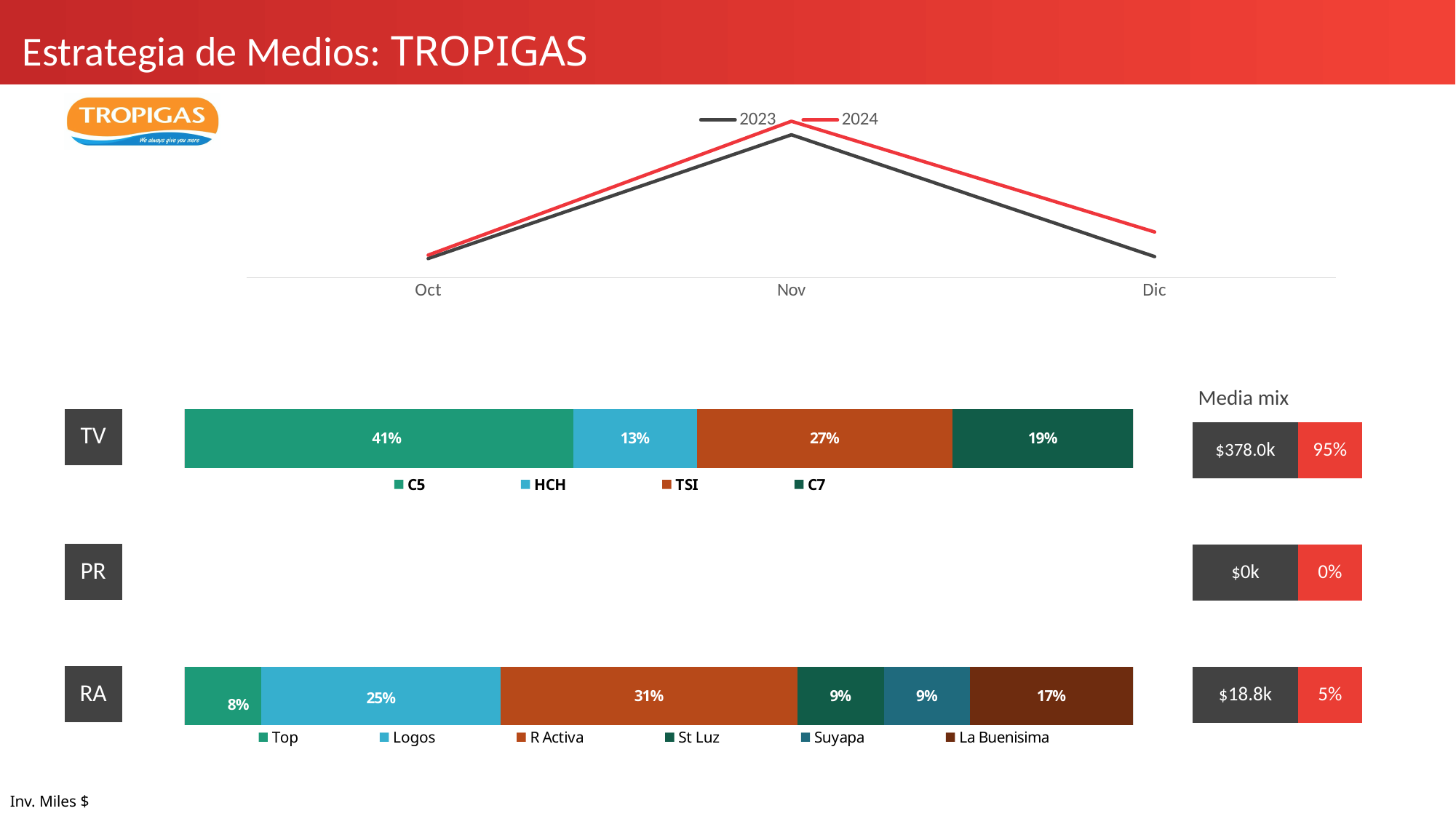
In the line chart at the top, does the 2023 line rise or fall from Nov to Dic? fall In the RA stacked bar, which station has the largest share? R Activa In the Media mix column, what is the investment shown for TV? $378.0k In the TV stacked bar, which channel has the smallest share? HCH In the line chart at the top, which series is higher in Dic, 2023 or 2024? 2024 In the line chart at the top, how many months are shown on the x axis? 3 In the line chart at the top, what kind of chart is it? line chart In the line chart at the top, in which month does the 2024 line reach its highest point? Nov In the RA stacked bar, how many stations does the legend list? 6 In the TV stacked bar, what is the difference between the TSI share and the C7 share? 8% In the TV stacked bar, what share does C5 have? 41% In the line chart at the top, how many series does the legend list? 2